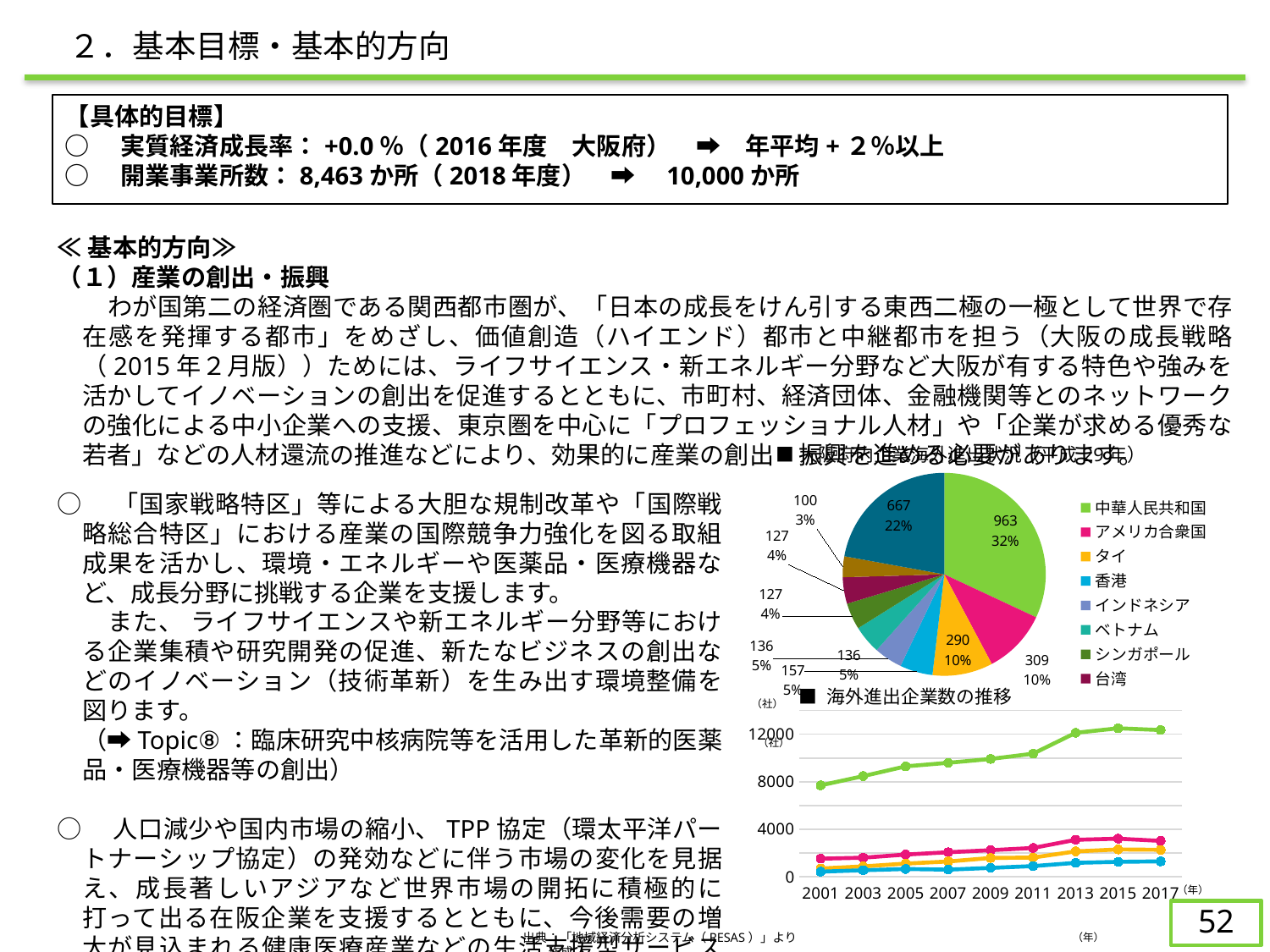
In the pie chart, what value is shown for 中華人民共和国? 963 In the pie chart, what percentage share is shown for 中華人民共和国? 32% In the chart 海外進出企業数の推移, how many lines are plotted? 4 What kind of chart is the chart at the top right of the slide? Pie chart In the pie chart, which country has the largest slice? 中華人民共和国 In the chart 海外進出企業数の推移, what is the first year shown on the x axis? 2001 What is the title of the chart at the bottom right of the slide? 海外進出企業数の推移 How many entries does the legend of the pie chart list? 8 In the chart 海外進出企業数の推移, is the value of the pink line in 2017 greater or less than 4000? less What kind of chart is 海外進出企業数の推移? Line chart In the chart 海外進出企業数の推移, does the green line rise or fall from 2001 to 2017? Rises